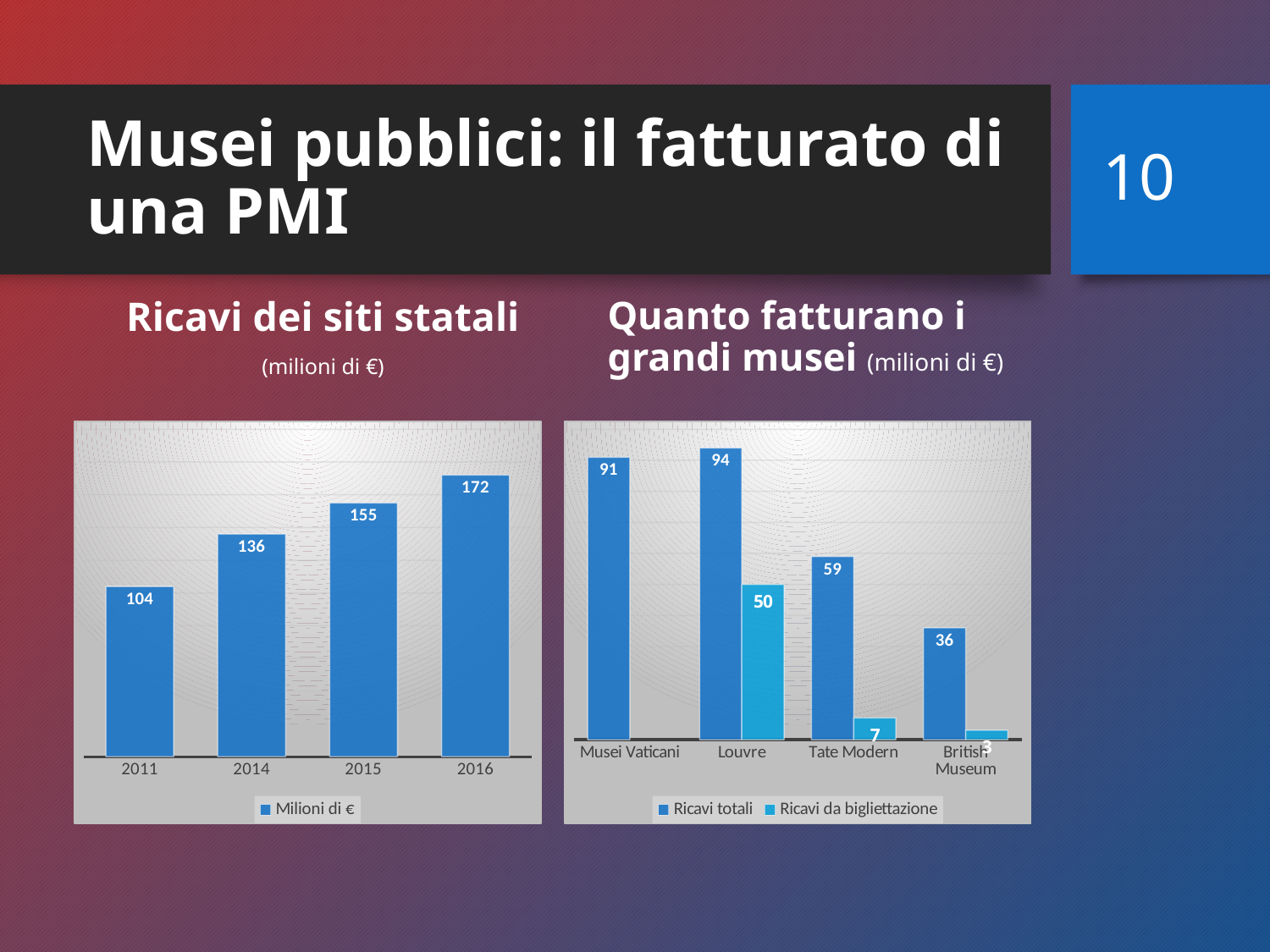
In the chart 'Ricavi dei siti statali', what is the difference between the values for 2016 and 2011? 68 In the chart 'Quanto fatturano i grandi musei', which museum has the lowest 'Ricavi totali'? British Museum In the chart 'Quanto fatturano i grandi musei', what is the difference between 'Ricavi totali' and 'Ricavi da bigliettazione' for the Louvre? 44 In the chart 'Ricavi dei siti statali', how many years are shown? 4 What kind of chart is 'Quanto fatturano i grandi musei'? bar chart In the chart 'Ricavi dei siti statali', which year has the highest value? 2016 In the chart 'Quanto fatturano i grandi musei', what is the value of 'Ricavi da bigliettazione' for Tate Modern? 7 In the chart 'Ricavi dei siti statali', which year has the lowest value? 2011 In the chart 'Quanto fatturano i grandi musei', what is the value of 'Ricavi totali' for the Louvre? 94 In the chart 'Ricavi dei siti statali', what is the value for 2014? 136 In the chart 'Quanto fatturano i grandi musei', how many series does the legend list? 2 In the chart 'Ricavi dei siti statali', do the values rise or fall from 2011 to 2016? rise